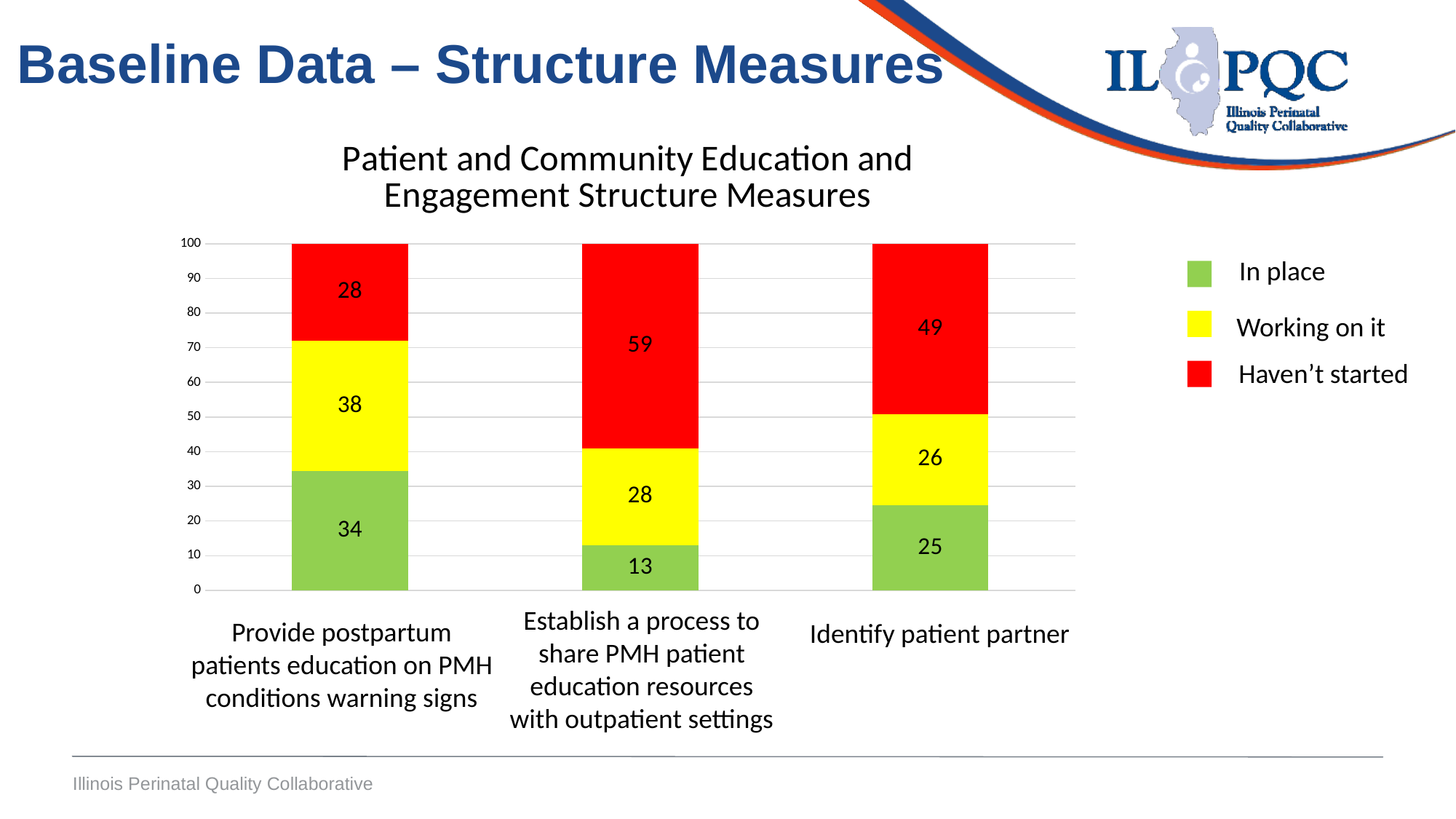
Which category has the highest "Haven't started" value? Establish a process to share PMH patient education resources with outpatient settings What is the "Haven't started" value for "Establish a process to share PMH patient education resources with outpatient settings"? 59 Which category has the lowest "In place" value? Establish a process to share PMH patient education resources with outpatient settings What kind of chart is shown on the slide? Stacked bar chart What is the "In place" value for "Provide postpartum patients education on PMH conditions warning signs"? 34 How many series does the legend list? 3 How many categories are shown on the x axis? 3 Which is larger: the "In place" value for "Identify patient partner" or the "In place" value for "Establish a process to share PMH patient education resources with outpatient settings"? Identify patient partner Which colour represents "Working on it" in the legend? Yellow What is the total of the stacked bar for "Identify patient partner"? 100 What is the "Working on it" value for "Identify patient partner"? 26 What is the difference between the "Working on it" values for "Provide postpartum patients education on PMH conditions warning signs" and "Identify patient partner"? 12